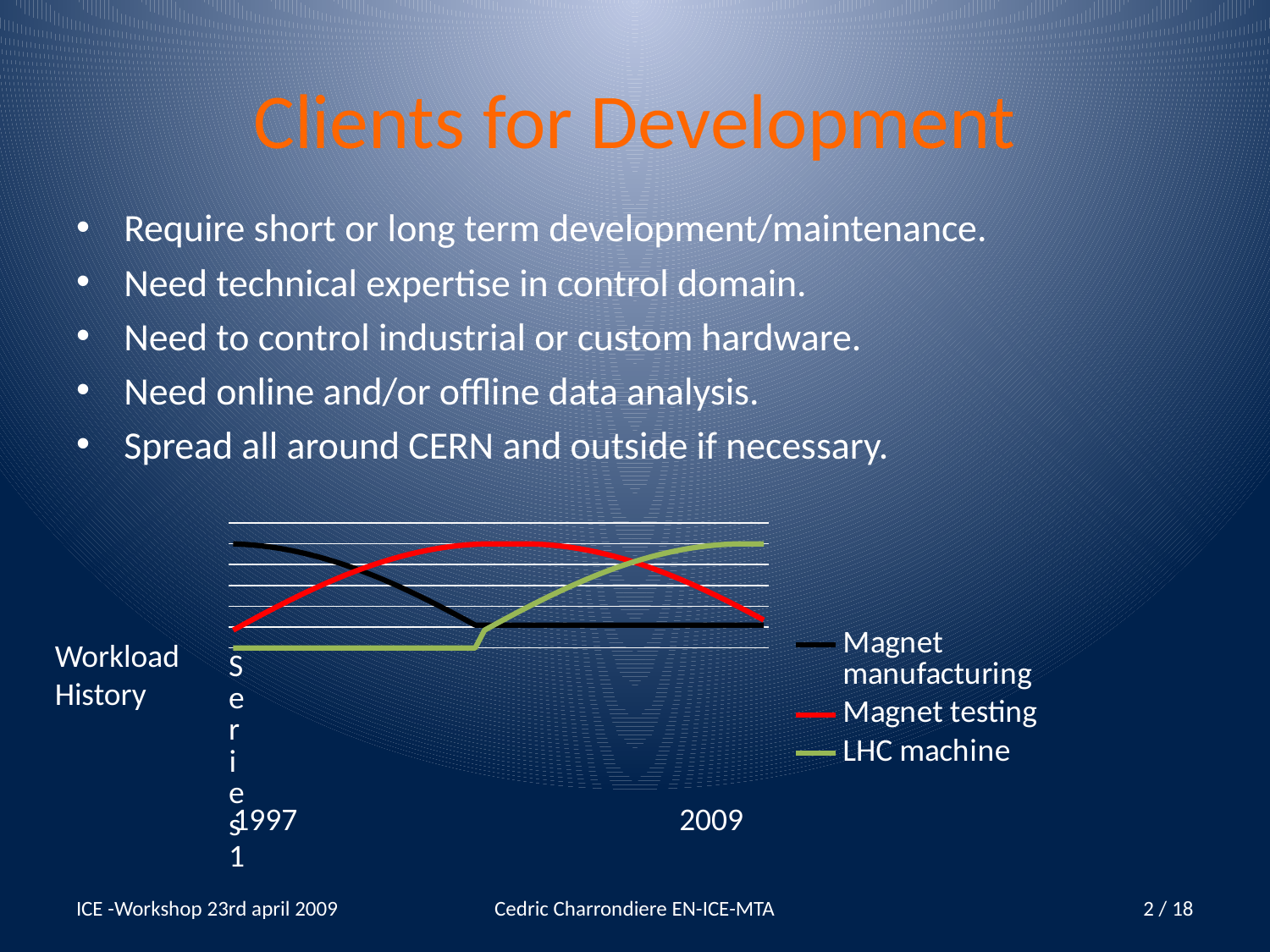
How many series does the chart's legend list? 3 Does the LHC machine line rise or fall toward 2009? rise Which series is drawn in red in the chart? Magnet testing What are the two year labels shown on the chart's x axis? 1997 and 2009 Which series is drawn in green in the chart? LHC machine Which series is highest at the 2009 end of the chart? LHC machine What kind of chart is shown on the slide? line chart At 2009, which is larger: Magnet testing or Magnet manufacturing? Magnet testing Which series is lowest at the 2009 end of the chart? Magnet manufacturing Does the Magnet manufacturing line rise or fall from 1997 onward? fall Which series is highest at the 1997 start of the chart? Magnet manufacturing At 1997, which is larger: Magnet manufacturing or LHC machine? Magnet manufacturing